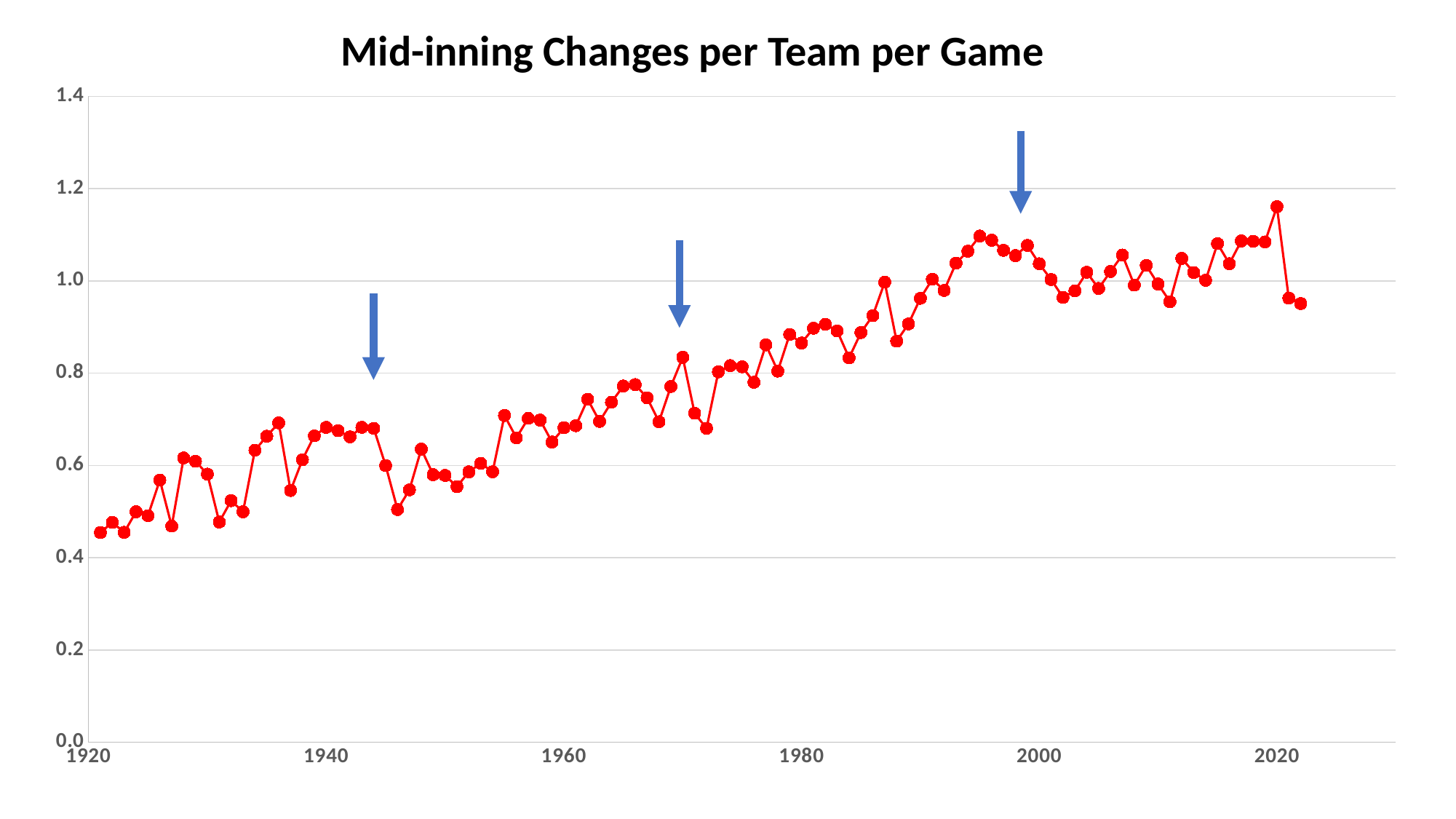
Is the value for 1940 greater or less than 0.6? greater Is the value for 1980 greater or less than 0.8? greater What kind of chart is shown on the slide? line chart Is the value for 1920 greater or less than 0.6? less Overall, do the values rise or fall from 1920 to 2020? rise Which year has the highest value on the chart? 2020 Which is larger, the value for 1920 or the value for 2000? 2000 How many blue arrows are drawn on the chart? 3 What is the title of the chart? Mid-inning Changes per Team per Game